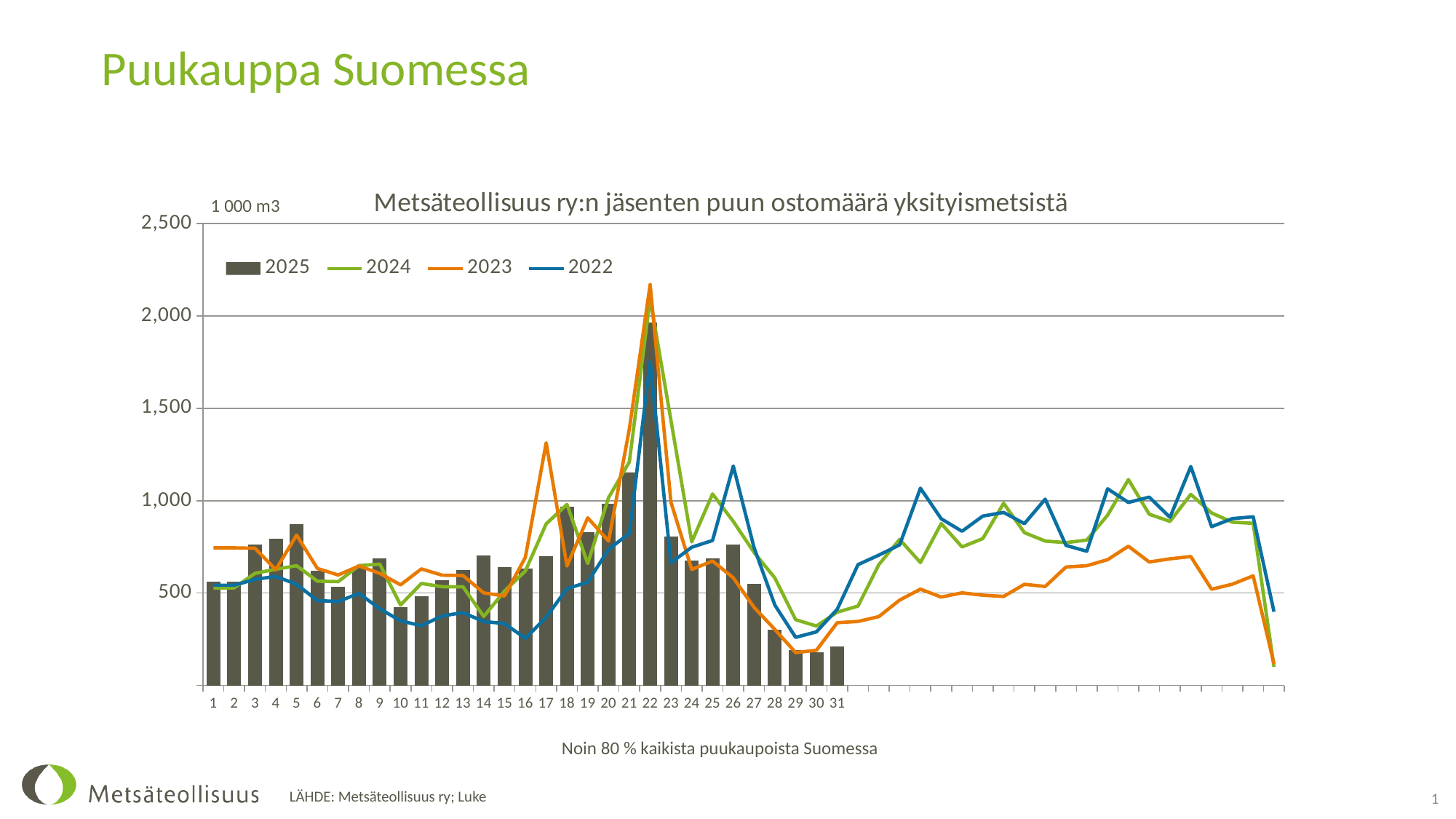
What is the title of the chart? Metsäteollisuus ry:n jäsenten puun ostomäärä yksityismetsistä Is the 2023 value at week 22 greater or less than 2,000? greater Is the 2025 value for week 22 greater or less than 1,500? greater Is the 2025 value for week 29 greater or less than 500? less How many series does the legend list? 4 Do the 2025 bars rise or fall from week 22 to week 30? Fall What kind of chart is shown on the slide? A combined bar and line chart Which 2025 bar is taller, week 5 or week 7? Week 5 In which week is the 2025 bar highest? 22 How many weeks have a 2025 bar plotted? 31 Which series is shown as bars rather than lines? 2025